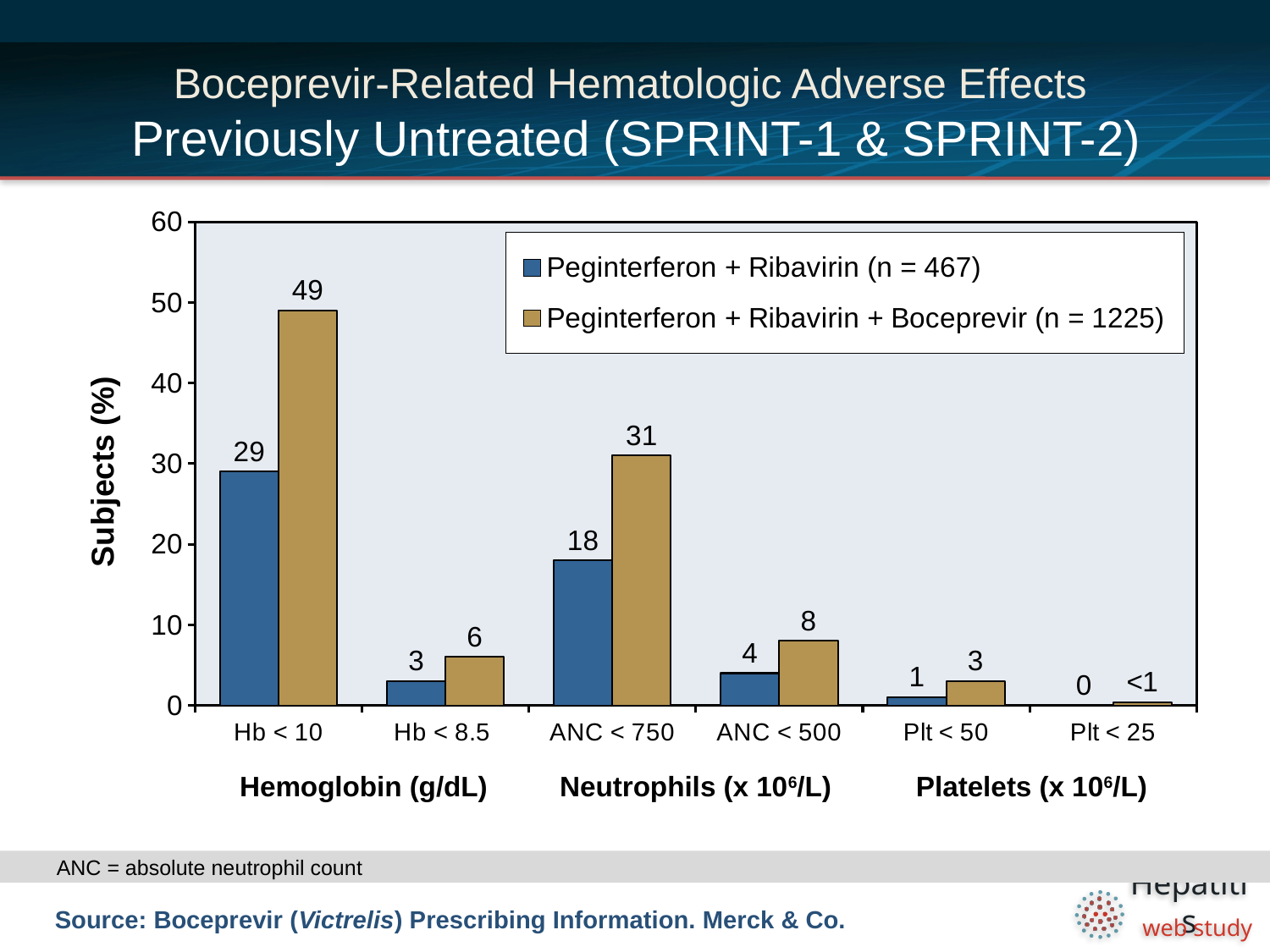
What percentage of subjects in the Peginterferon + Ribavirin group had ANC < 750? 18 What is the difference between the two groups for ANC < 750? 13 What percentage of subjects in the Peginterferon + Ribavirin + Boceprevir group had Hb < 10? 49 Which category has the highest value for the Peginterferon + Ribavirin + Boceprevir group? Hb < 10 Which category has the lowest value for the Peginterferon + Ribavirin group? Plt < 25 How many series does the legend list? 2 What is the difference between the two groups for Hb < 10? 20 For ANC < 500, which group has the larger value? Peginterferon + Ribavirin + Boceprevir Is the value for Hb < 10 in the Peginterferon + Ribavirin + Boceprevir group greater or less than 40? greater What kind of chart is shown on the slide? Bar chart What is the value for Plt < 25 in the Peginterferon + Ribavirin + Boceprevir group? <1 How many categories are shown on the x axis? 6